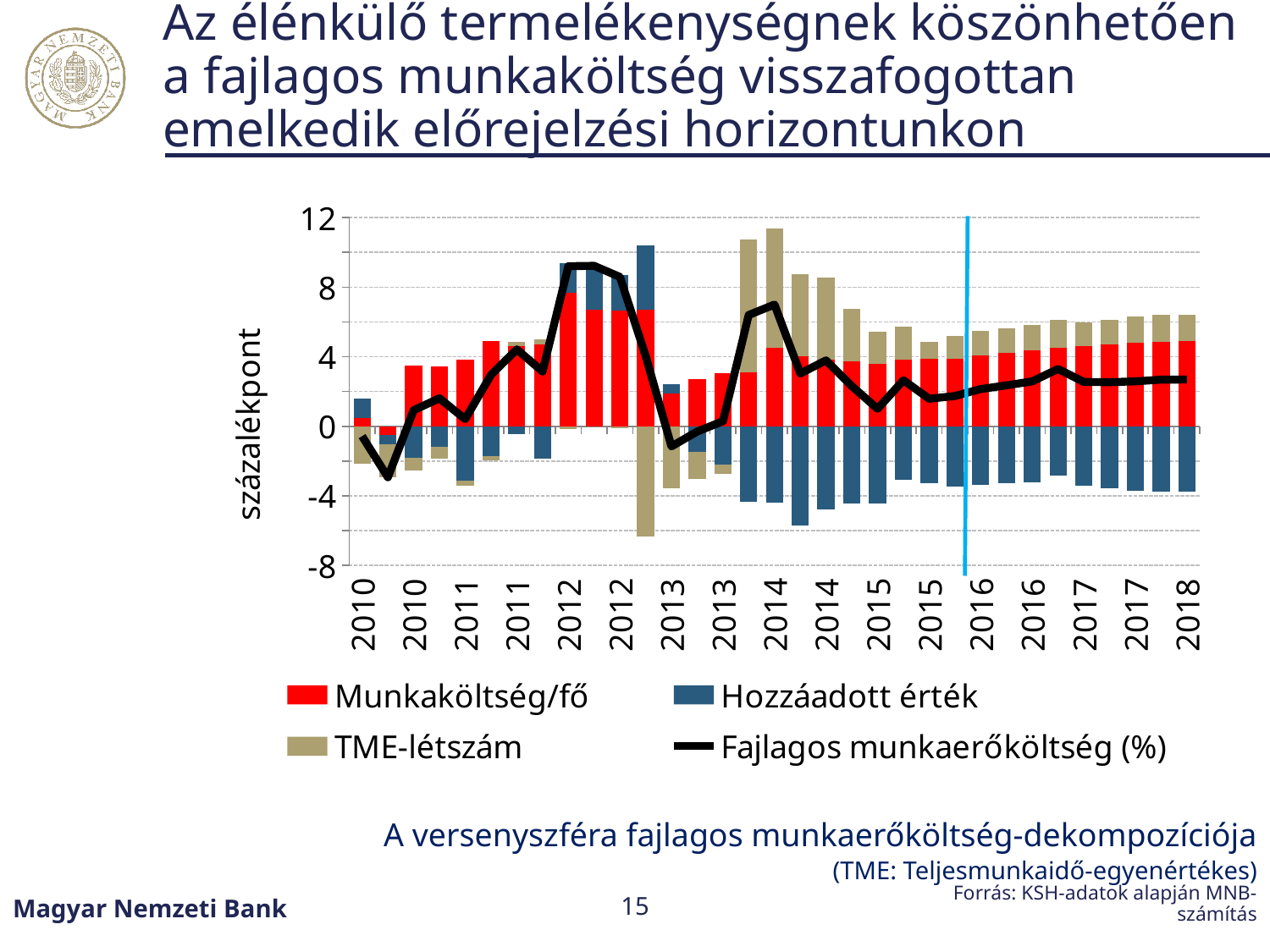
Does the Fajlagos munkaerőköltség (%) line rise or fall between the second 2012 point and the first 2013 point? fall What kind of chart is shown on the slide? Stacked bar chart with a line Is the Hozzáadott érték value at the second 2014 period greater or less than -4? less How many series does the legend list? 4 Is the top of the stacked bar at the first 2014 period greater or less than 8? greater At which x-axis point does the Fajlagos munkaerőköltség (%) line reach its lowest value? The second 2010 bar (second quarter of 2010, between the two 2010 labels) What is the label on the vertical axis of the chart? százalékpont How many bars (time periods) are plotted along the x axis? 33 Is the value of the Fajlagos munkaerőköltség (%) line at the first 2012 point greater or less than 8? greater Which legend entry is drawn as a black line? Fajlagos munkaerőköltség (%)